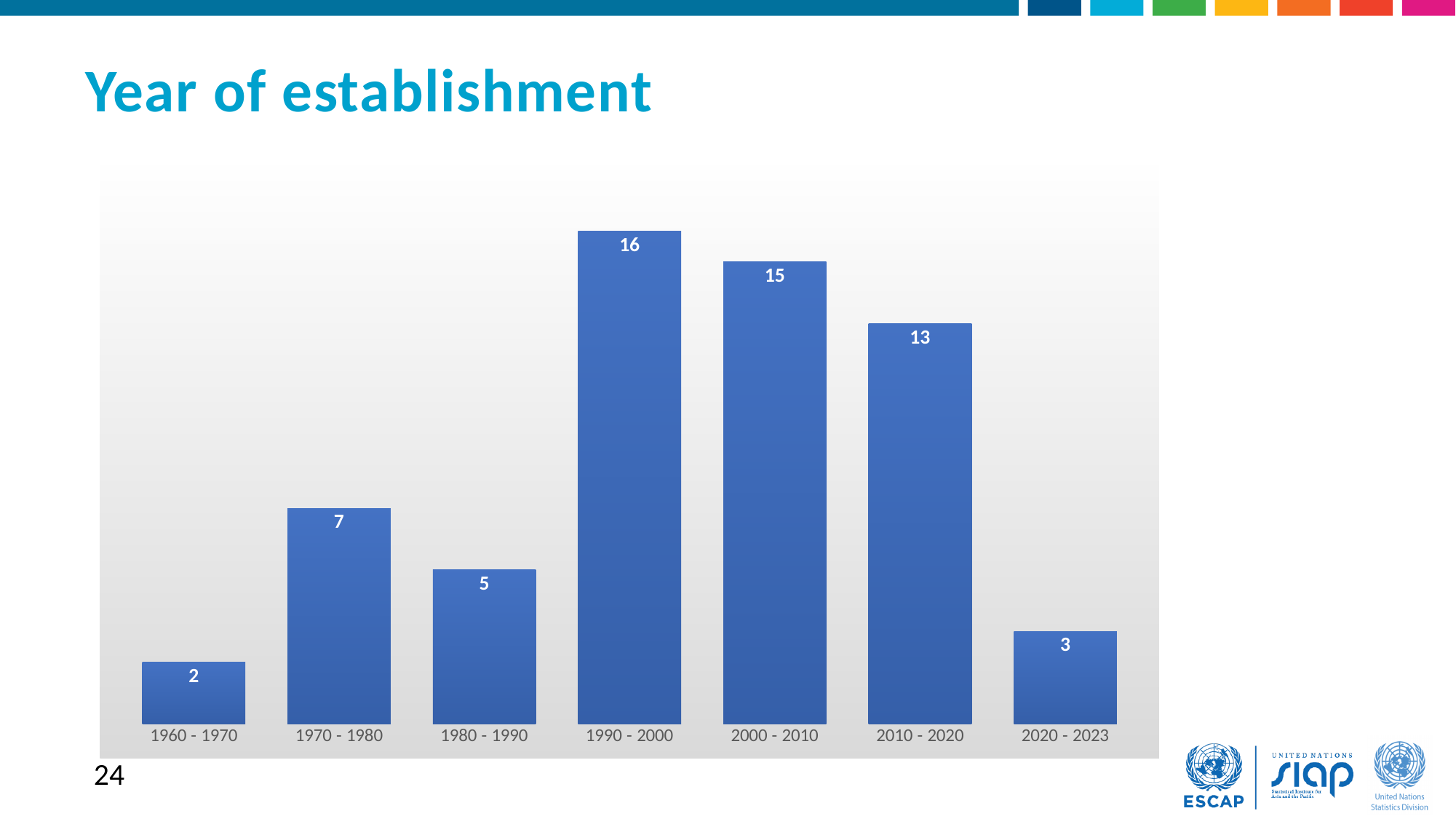
Do the values rise or fall from 1990 - 2000 to 2020 - 2023? Fall What kind of chart is shown on the slide? Bar chart What is the title of the slide? Year of establishment Which is larger, the value for 1970 - 1980 or the value for 2020 - 2023? 1970 - 1980 Which period has the lowest value? 1960 - 1970 What is the value for 2010 - 2020? 13 What is the difference between the values for 1970 - 1980 and 1980 - 1990? 2 How many periods are shown on the x axis? 7 What is the value for 1960 - 1970? 2 What is the difference between the values for 1990 - 2000 and 2000 - 2010? 1 What is the value for 1990 - 2000? 16 Which period has the highest value? 1990 - 2000